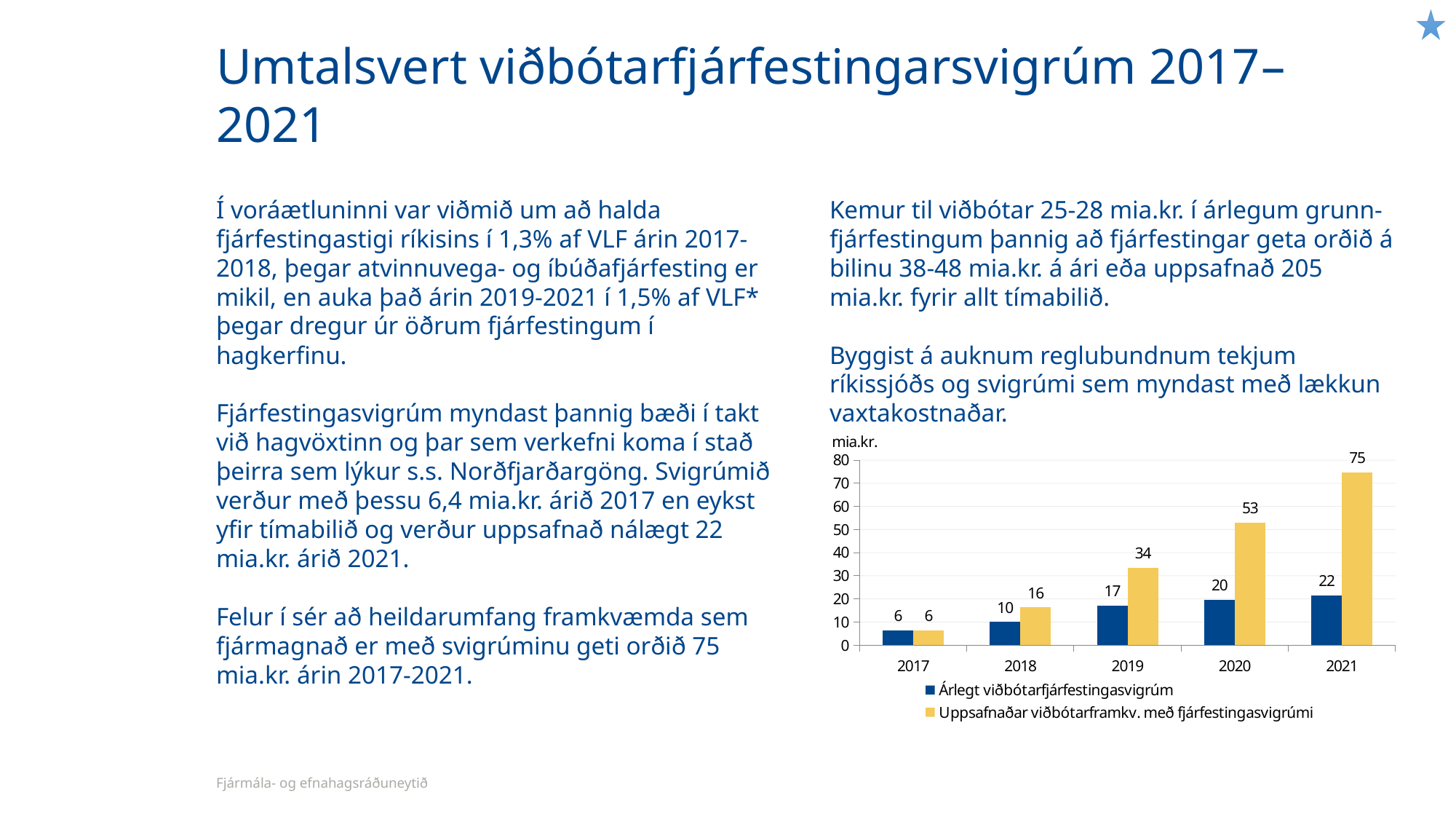
What kind of chart is shown on the slide? Bar chart Which year has the lowest value for Árlegt viðbótarfjárfestingasvigrúm? 2017 What is the difference between the Uppsafnaðar viðbótarframkv. með fjárfestingasvigrúmi values for 2021 and 2020? 22 How many series does the chart legend list? 2 Which year has the highest value for Uppsafnaðar viðbótarframkv. með fjárfestingasvigrúmi? 2021 Which is larger in 2018: Árlegt viðbótarfjárfestingasvigrúm or Uppsafnaðar viðbótarframkv. með fjárfestingasvigrúmi? Uppsafnaðar viðbótarframkv. með fjárfestingasvigrúmi What is the value of Árlegt viðbótarfjárfestingasvigrúm for 2019? 17 What is the value of Uppsafnaðar viðbótarframkv. með fjárfestingasvigrúmi for 2020? 53 What is the value of Árlegt viðbótarfjárfestingasvigrúm for 2017? 6 Do the values for Árlegt viðbótarfjárfestingasvigrúm rise or fall from 2017 to 2021? Rise What unit is shown above the y axis of the chart? mia.kr. How many years are shown on the x axis of the chart? 5